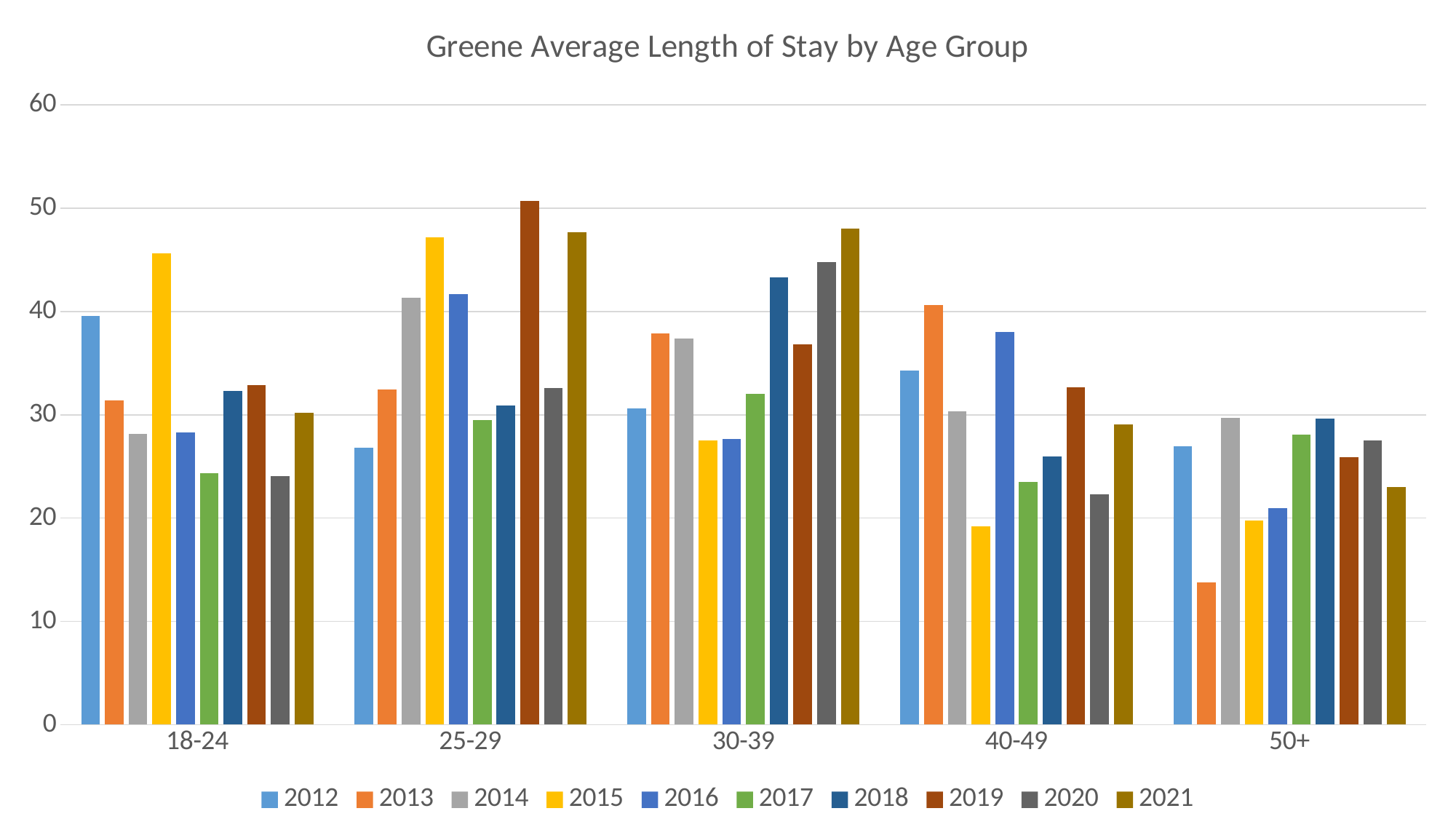
How many age groups are shown on the x axis? 5 For 2021, which age group has the larger value: 30-39 or 40-49? 30-39 What is the title of the chart? Greene Average Length of Stay by Age Group Is the value for 2015 in the 18-24 age group greater or less than 40? greater Within the 50+ age group, which year has the lowest value? 2013 How many series does the legend list? 10 Which age group has the highest value for 2019? 25-29 Is the value for 2013 in the 50+ age group greater or less than 20? less What kind of chart is shown on the slide? bar chart Within the 18-24 age group, which year has the highest value? 2015 Within the 40-49 age group, which year has the lowest value? 2015 Is the value for 2018 in the 30-39 age group greater or less than 40? greater